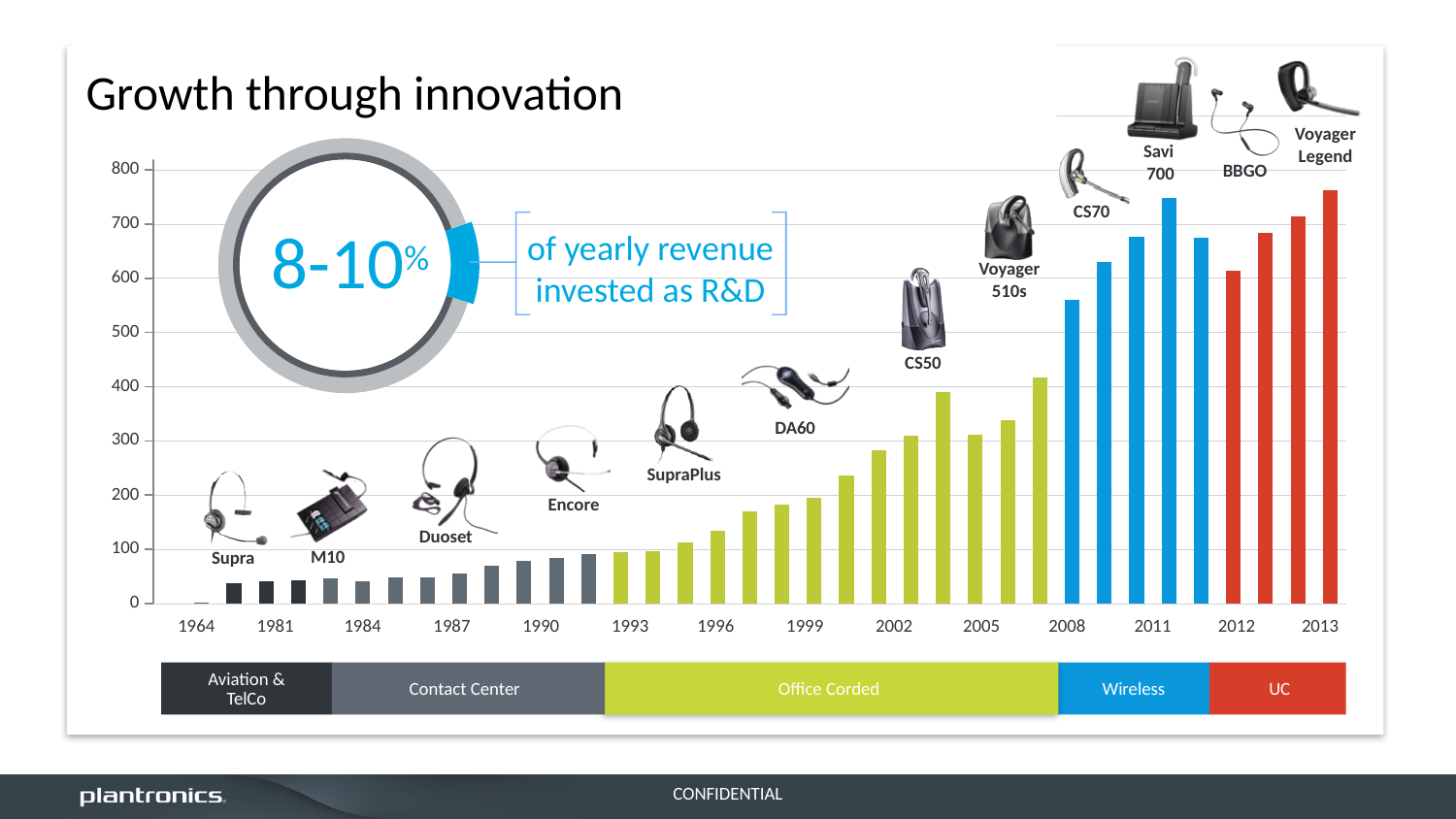
Is the value for 2011 greater or less than 600? greater What kind of chart is shown on the slide? bar chart Which bar is taller, 2013 or 2012? 2013 Which year has the shortest bar in the chart? 1964 Which year has the tallest bar in the chart? 2013 Which bar is taller, 2008 or 2005? 2008 Is the value for 1990 greater or less than 100? less Is the value for 2013 greater or less than 700? greater How many product segments are listed in the colour band below the chart? 5 Do the bar values generally rise or fall from 1964 to 2013? rise